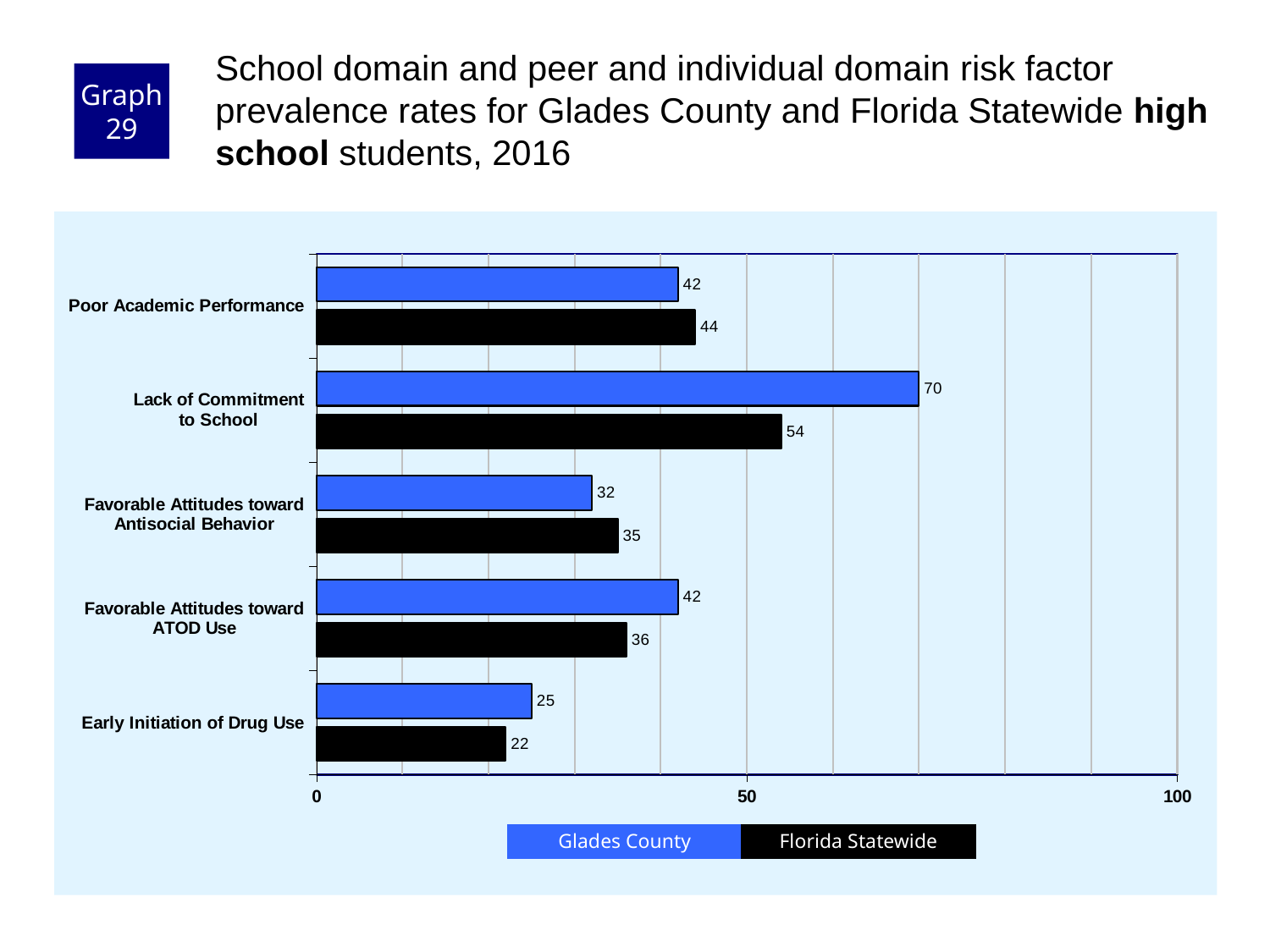
What is the Florida Statewide value for Favorable Attitudes toward Antisocial Behavior? 35 How many risk factor categories are shown on the chart? 5 What is the difference between the Glades County and Florida Statewide values for Lack of Commitment to School? 16 What is the Florida Statewide value for Early Initiation of Drug Use? 22 For Favorable Attitudes toward ATOD Use, which is larger: the Glades County value or the Florida Statewide value? Glades County Which risk factor has the highest Glades County value? Lack of Commitment to School Is the Florida Statewide value for Lack of Commitment to School greater or less than 50? greater What kind of chart is shown on the slide? Bar chart How many series does the legend list? 2 What is the Glades County value for Lack of Commitment to School? 70 Which colour represents Florida Statewide in the legend? Black Which risk factor has the lowest Florida Statewide value? Early Initiation of Drug Use